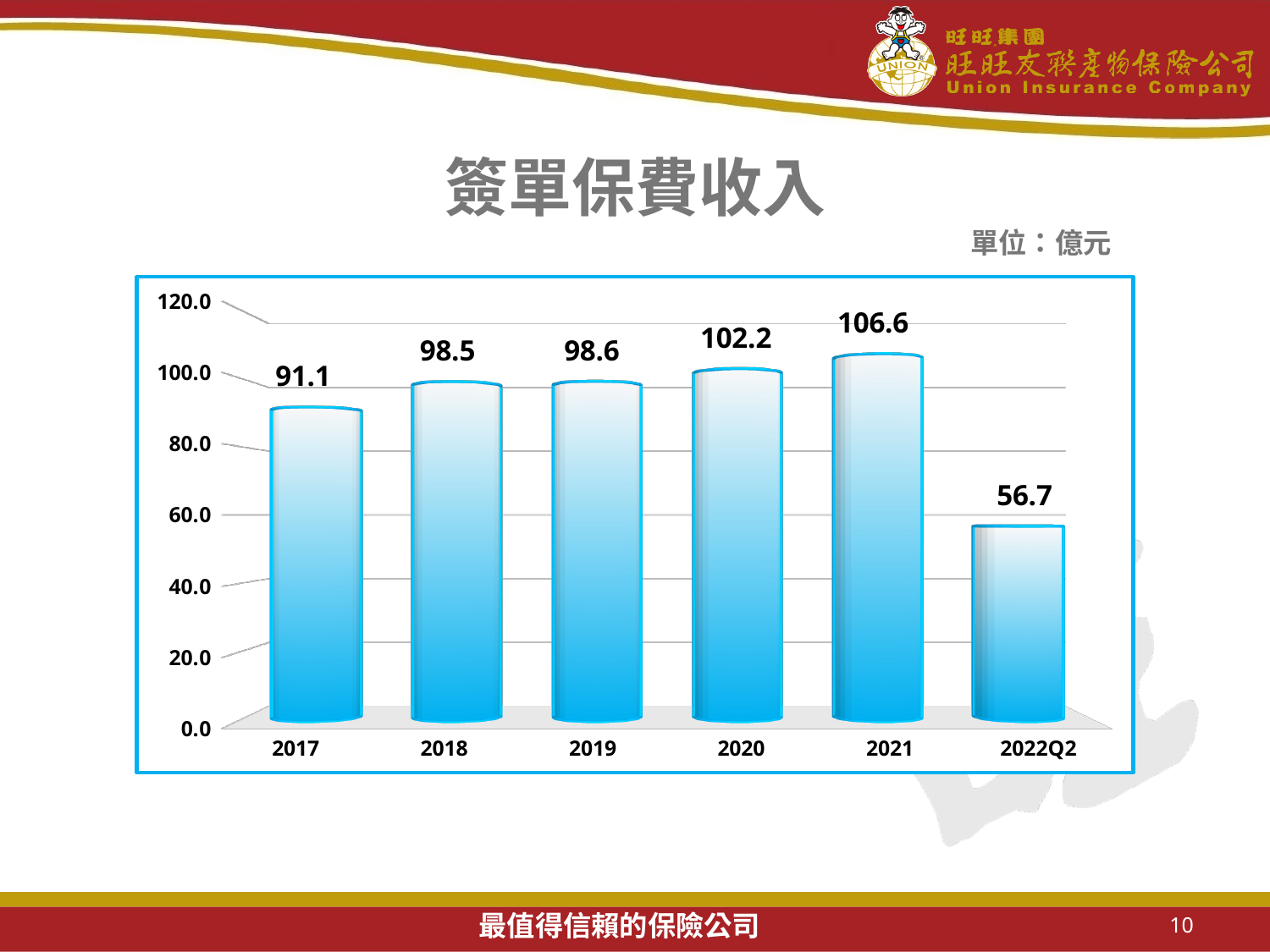
Do the values rise or fall from 2017 to 2021? rise Which is larger, the value for 2019 or the value for 2020? 2020 What is the difference between the values for 2021 and 2017? 15.5 What is the value for 2020? 102.2 What is the value for 2022Q2? 56.7 What is the title of the chart? 簽單保費收入 Which category has the highest value? 2021 What kind of chart is shown on the slide? bar chart What is the value for 2017? 91.1 Is the value for 2021 greater or less than 100.0? greater Which category has the lowest value? 2022Q2 How many categories are shown on the x axis? 6